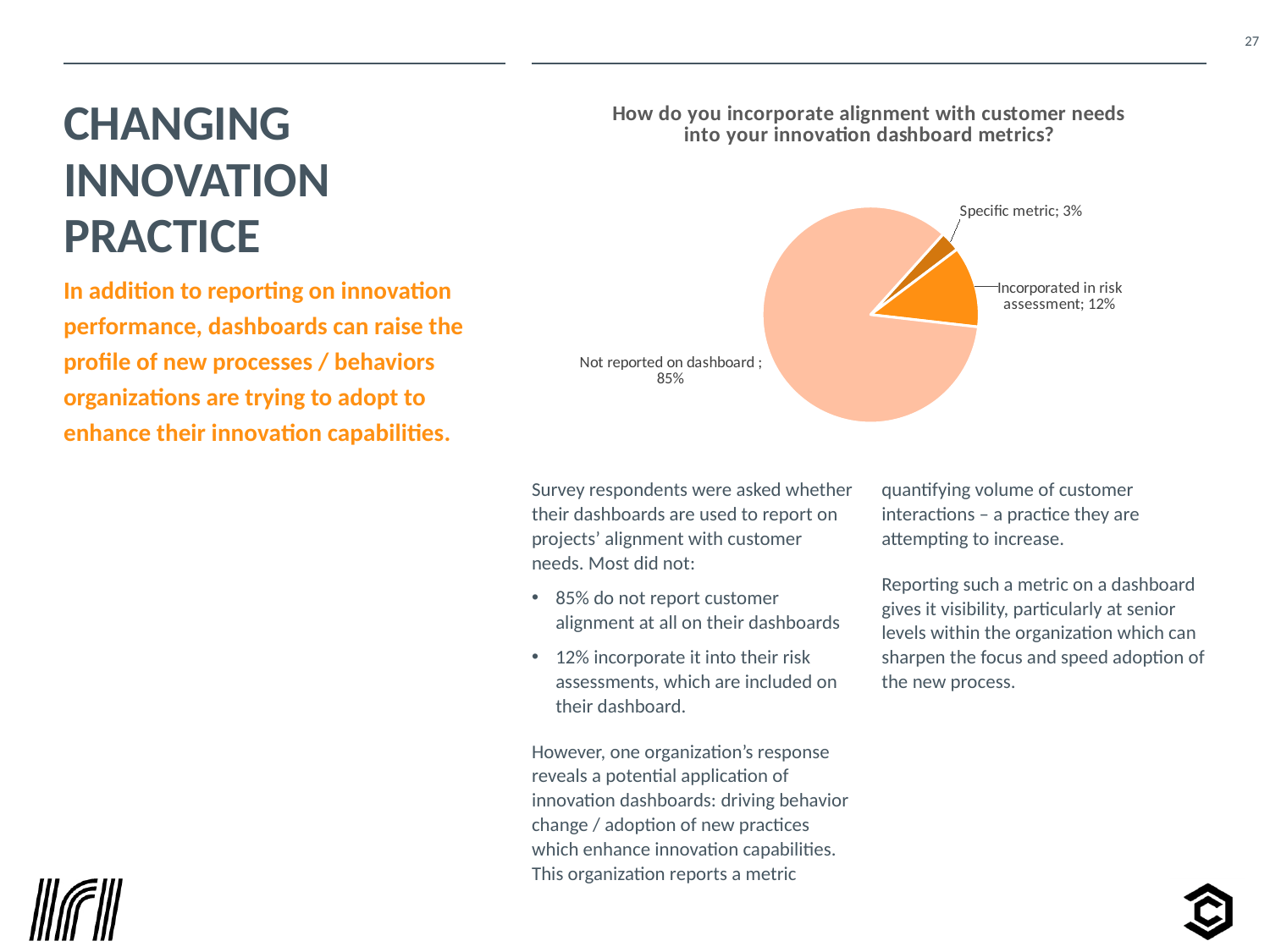
What colour is the 'Not reported on dashboard' slice? Light orange (peach) What kind of chart is shown on the slide? Pie chart What percentage of respondents answered 'Not reported on dashboard'? 85% Which category has the smallest share of the pie? Specific metric What is the difference in percentage points between 'Incorporated in risk assessment' and 'Specific metric'? 9 Which is larger: the share for 'Incorporated in risk assessment' or the share for 'Specific metric'? Incorporated in risk assessment How many categories are shown in the pie chart? 3 What is the title of the chart? How do you incorporate alignment with customer needs into your innovation dashboard metrics? What percentage of respondents answered 'Specific metric'? 3% What percentage of respondents answered 'Incorporated in risk assessment'? 12% Which category has the largest share of the pie? Not reported on dashboard What is the difference in percentage points between 'Not reported on dashboard' and 'Incorporated in risk assessment'? 73